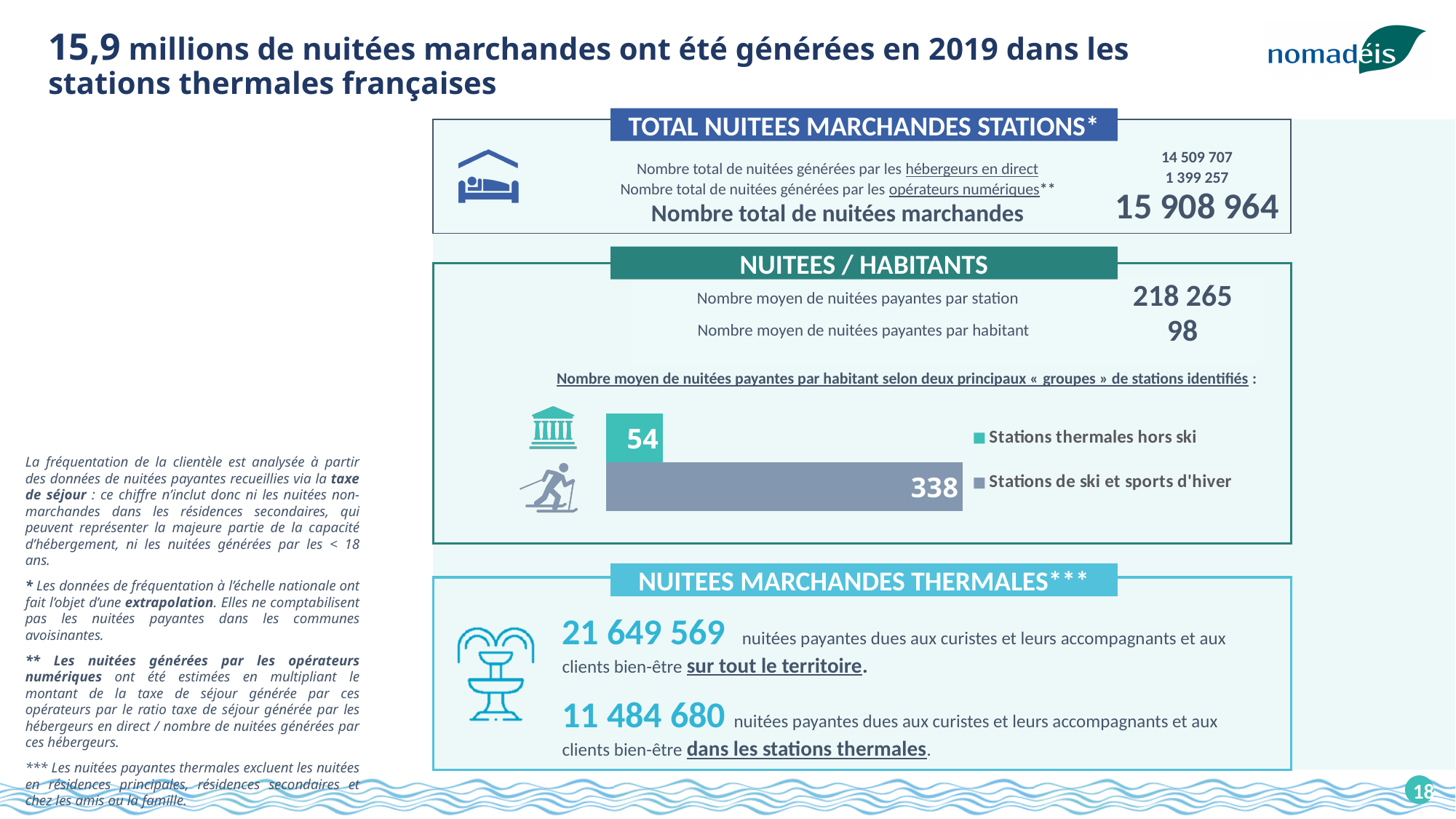
What type of chart is shown in the "NUITEES / HABITANTS" section? bar chart What colour is the bar for "Stations thermales hors ski"? teal/green What is the average number of paying overnight stays per inhabitant for "Stations thermales hors ski"? 54 What is the average number of paying overnight stays per inhabitant for "Stations de ski et sports d'hiver"? 338 Which group of stations has the lowest value in the bar chart? Stations thermales hors ski What colour is the bar for "Stations de ski et sports d'hiver"? grey-blue What is the difference between the values for "Stations de ski et sports d'hiver" and "Stations thermales hors ski" in the bar chart? 284 In the bar chart, is the value for "Stations thermales hors ski" larger or smaller than the value for "Stations de ski et sports d'hiver"? smaller How many bars are shown in the bar chart? 2 Which group of stations has the highest value in the bar chart? Stations de ski et sports d'hiver How many entries does the legend of the bar chart list? 2